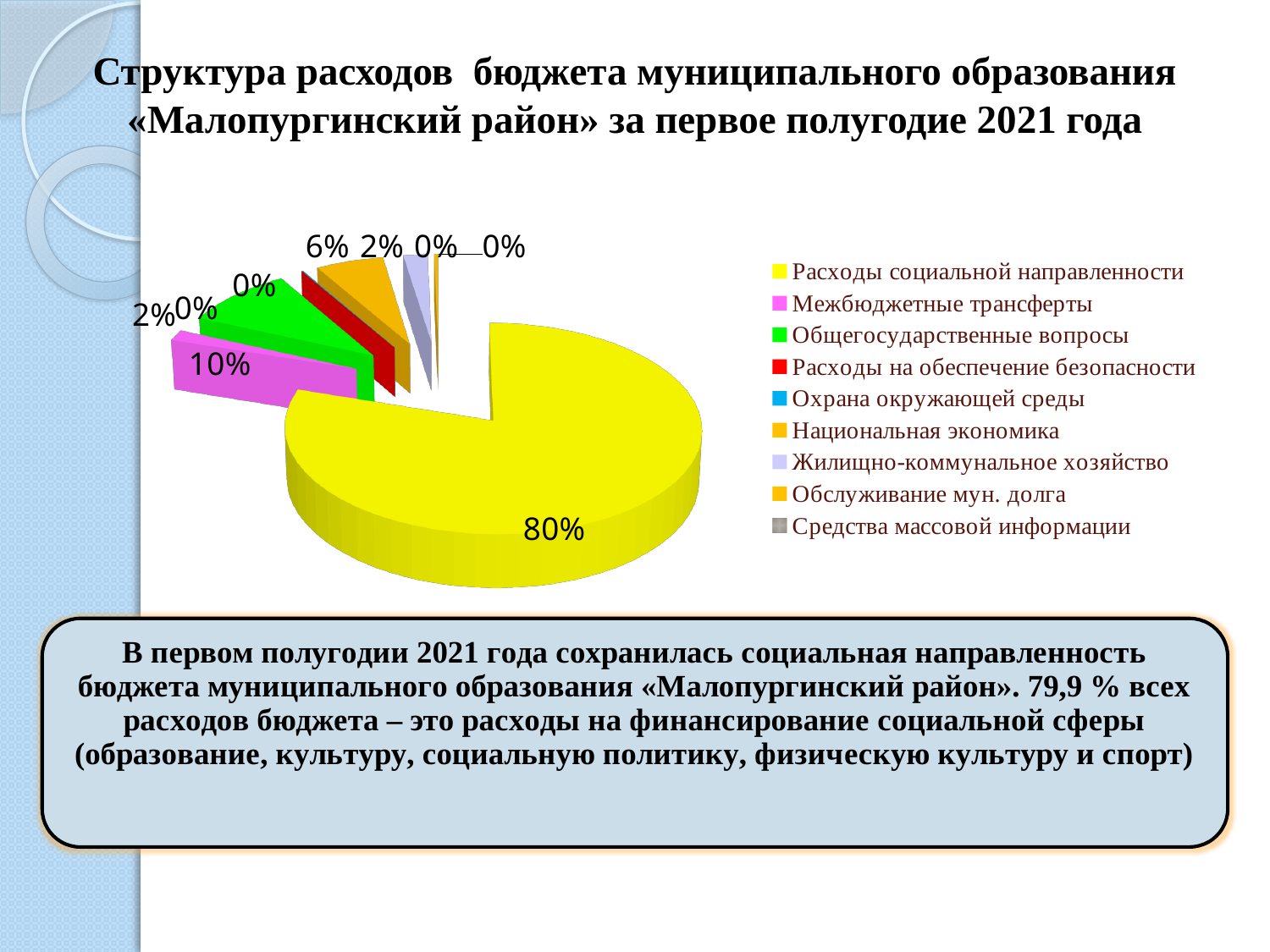
What type of chart is shown on the slide? Pie chart Which is larger: the share for Расходы социальной направленности or for Межбюджетные трансферты? Расходы социальной направленности Which category has the largest share of the pie? Расходы социальной направленности What is the title of the slide containing the chart? Структура расходов бюджета муниципального образования «Малопургинский район» за первое полугодие 2021 года Which category has the second largest share of the pie? Общегосударственные вопросы How many slices are labeled 0%? 4 What share of the budget expenses is labeled for Межбюджетные трансферты? 2% How many categories does the legend list? 9 What share of the budget expenses is labeled for Расходы социальной направленности? 80% What colour is the slice for Расходы социальной направленности? Yellow What is the difference in percentage points between the share for Расходы социальной направленности and the share for Межбюджетные трансферты? 78